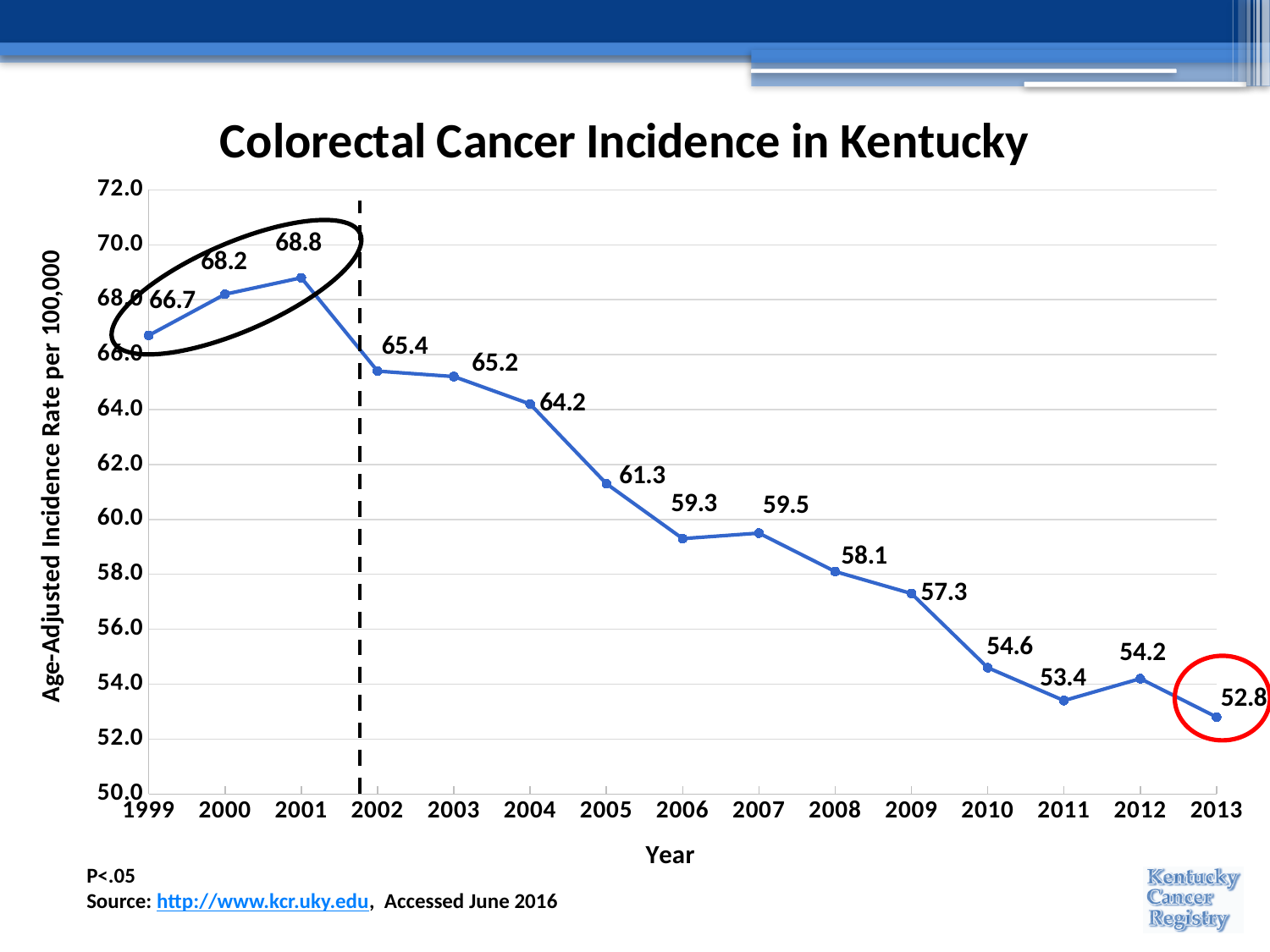
Which year has the lowest incidence rate? 2013 What is the difference between the incidence rates for 2004 and 2005? 2.9 How many years are plotted on the chart? 15 What is the incidence rate shown for 2006? 59.3 Is the incidence rate for 2009 greater or less than 58.0? less Which year has the highest incidence rate? 2001 What is the overall trend of the incidence rate from 1999 to 2013? falling What is the incidence rate shown for 2013? 52.8 What kind of chart is shown on the slide? line chart Which year has a higher incidence rate, 2006 or 2007? 2007 What is the age-adjusted colorectal cancer incidence rate in Kentucky for 2001? 68.8 What is the difference between the incidence rates for 2001 and 2013? 16.0